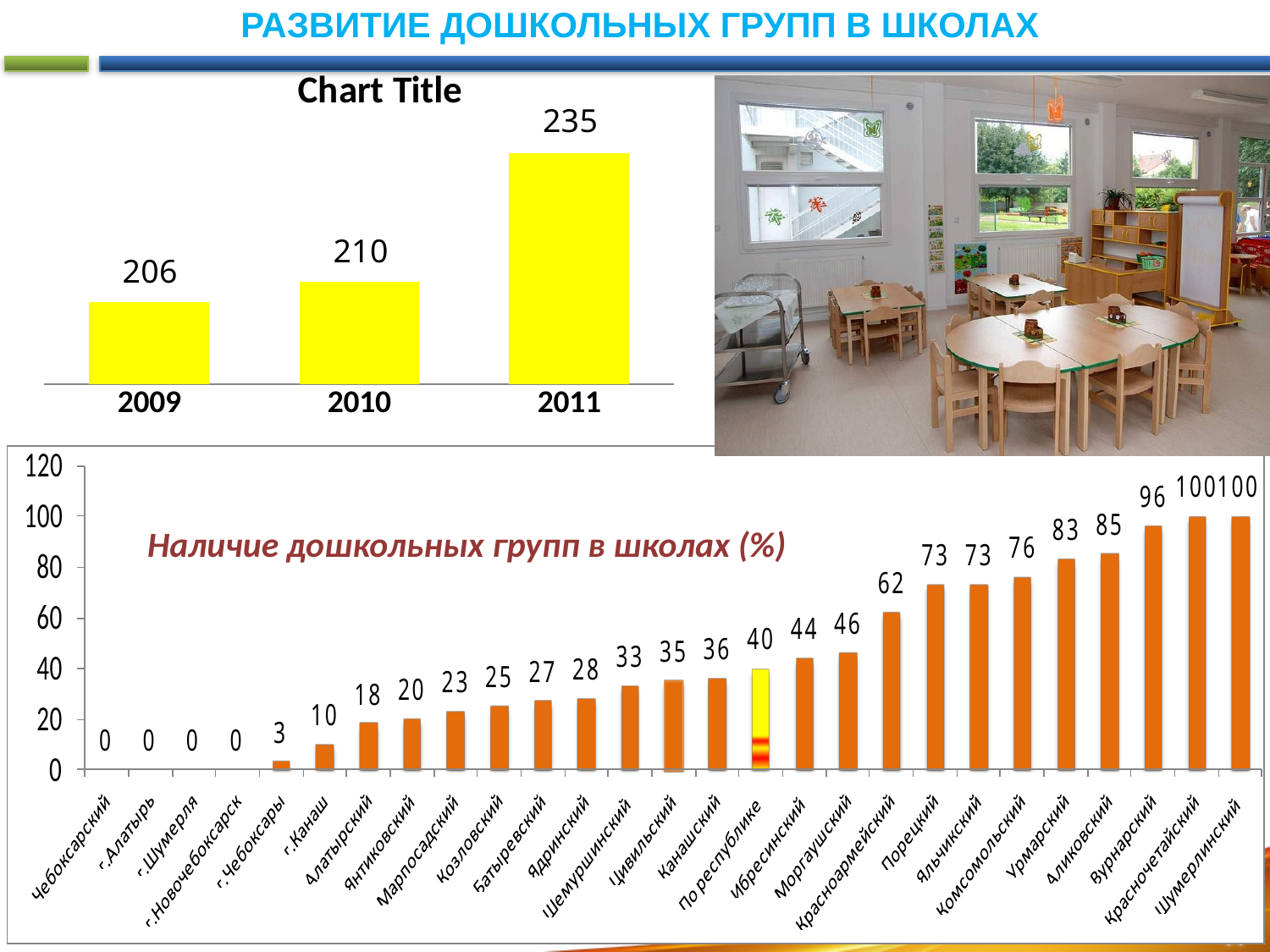
In the top-left chart titled "Chart Title", what is the difference between the values for 2011 and 2010? 25 In the top-left chart titled "Chart Title", do the values rise or fall from 2009 to 2011? rise In the top-left chart titled "Chart Title", what is the value for 2011? 235 In the top-left chart titled "Chart Title", how many years are shown? 3 What type of chart is the bottom chart "Наличие дошкольных групп в школах (%)"? bar chart In the bottom chart "Наличие дошкольных групп в школах (%)", how many categories are shown on the x axis? 27 In the bottom chart "Наличие дошкольных групп в школах (%)", what is the value for Красноармейский? 62 In the bottom chart "Наличие дошкольных групп в школах (%)", which is larger, the value for Урмарский or the value for Порецкий? Урмарский In the bottom chart "Наличие дошкольных групп в школах (%)", what is the value for Вурнарский? 96 In the top-left chart titled "Chart Title", what is the value for 2009? 206 In the bottom chart "Наличие дошкольных групп в школах (%)", what is the value for По республике? 40 In the bottom chart "Наличие дошкольных групп в школах (%)", what is the difference between the values for Аликовский and Ибресинский? 41